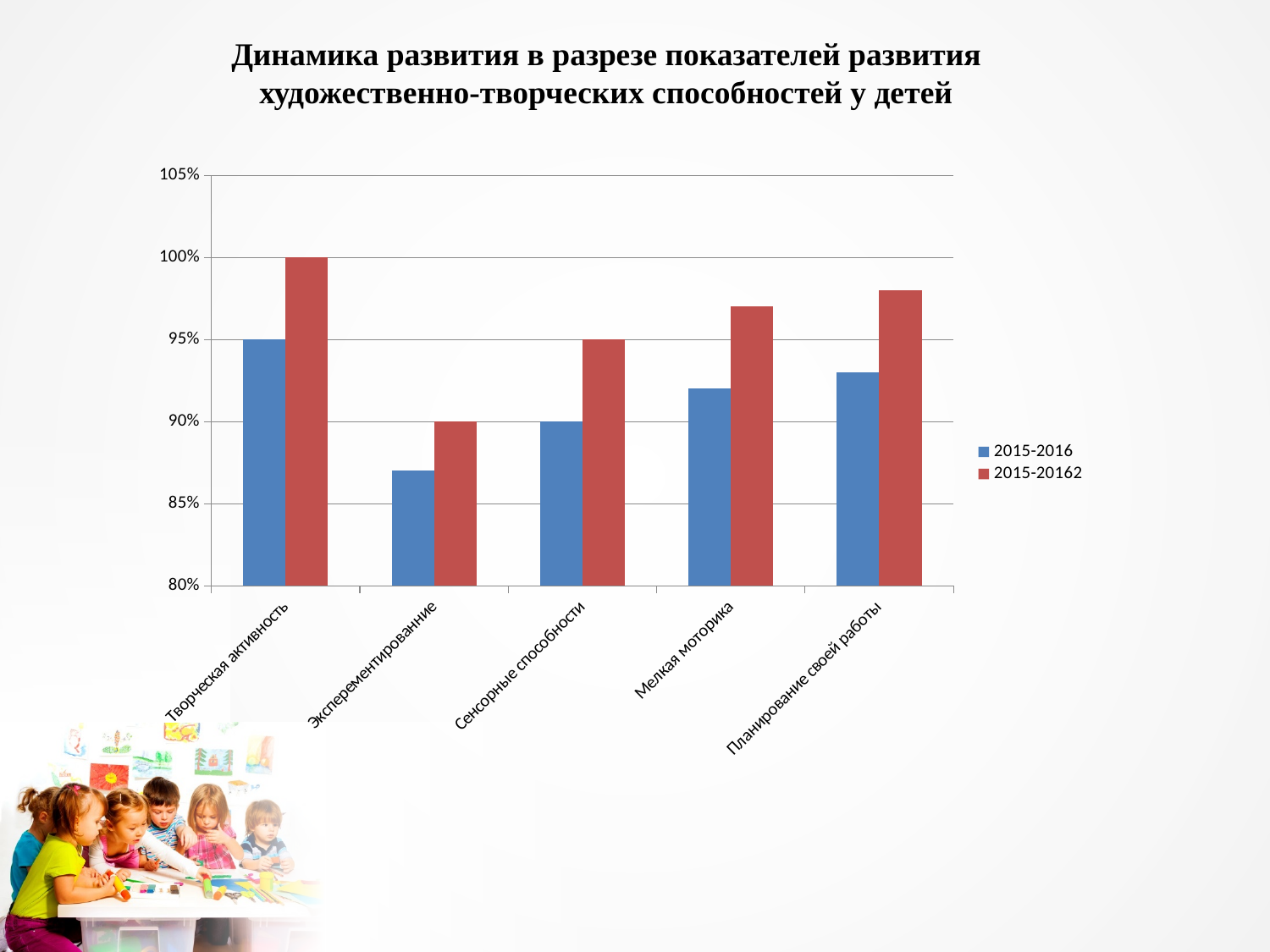
Which category has the highest value in the 2015-20162 series? Творческая активность Which is larger for Планирование своей работы: the 2015-2016 value or the 2015-20162 value? 2015-20162 Is the value for Мелкая моторика in the 2015-2016 series greater or less than 90%? greater Is the value for Экспереминтированние in the 2015-2016 series greater or less than 90%? less How many series does the legend list? 2 What is the value for Сенсорные способности in the 2015-2016 series? 90% What kind of chart is shown on the slide? bar chart What is the value for Творческая активность in the 2015-20162 series? 100% Which category has the lowest value in the 2015-2016 series? Эксперементированние What is the value for Сенсорные способности in the 2015-20162 series? 95% How many categories are shown on the x axis? 5 What is the value for Творческая активность in the 2015-2016 series? 95%